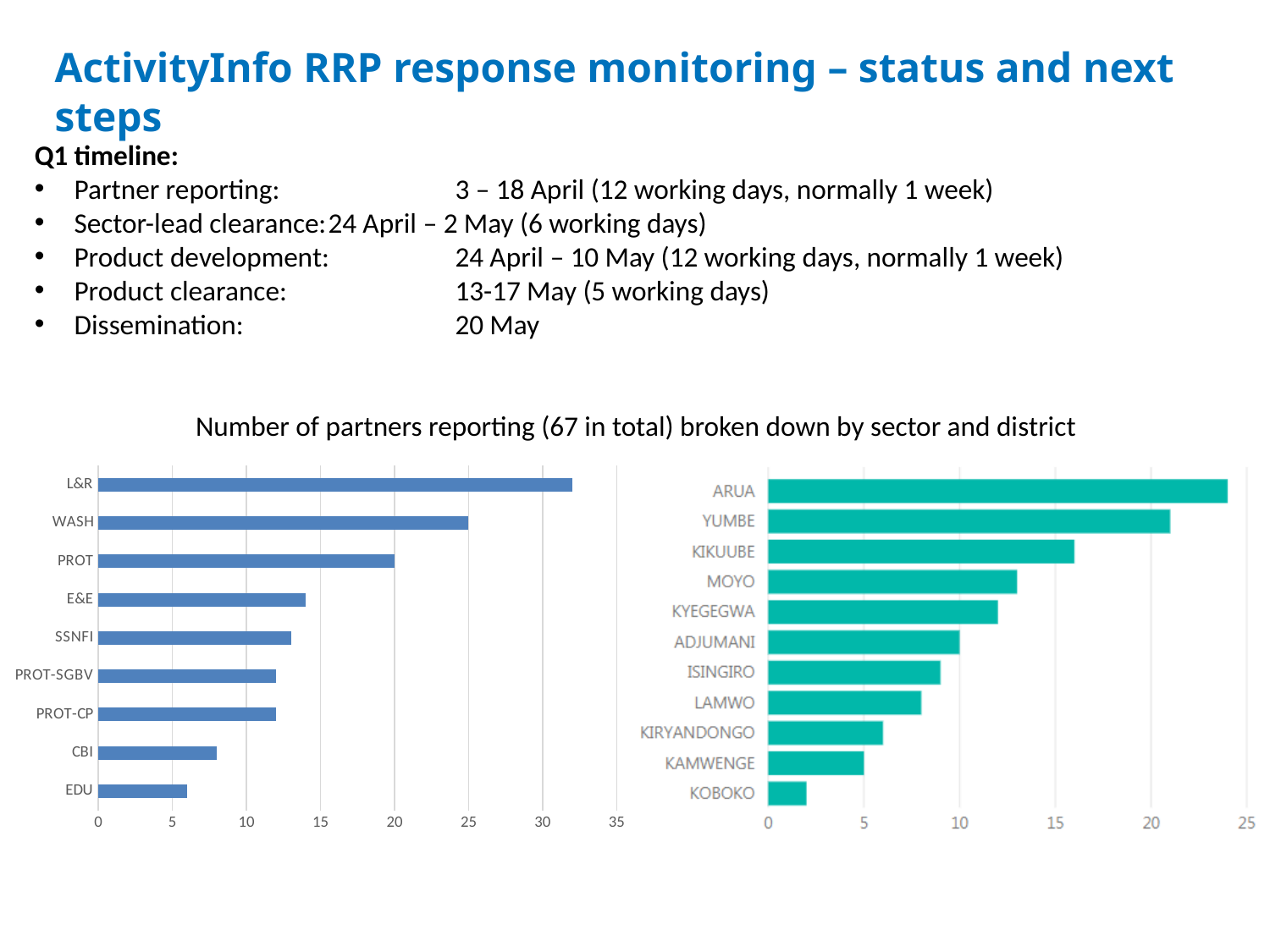
In the right chart (by district), which district has the highest number of partners reporting? ARUA In the left chart (by sector), which sector has the highest number of partners reporting? L&R In the left chart (by sector), is the value for L&R greater or less than 30? greater What is the title shown above the two charts? Number of partners reporting (67 in total) broken down by sector and district How many districts are shown in the right chart? 11 In the left chart (by sector), which sector has the lowest number of partners reporting? EDU In the left chart (by sector), which has more partners reporting, WASH or PROT? WASH What kind of chart is the left chart showing sectors? bar chart How many sectors are shown in the left chart? 9 In the right chart (by district), is the value for YUMBE greater or less than 20? greater In the right chart (by district), which district has the lowest number of partners reporting? KOBOKO In the left chart (by sector), is the value for CBI greater or less than 10? less